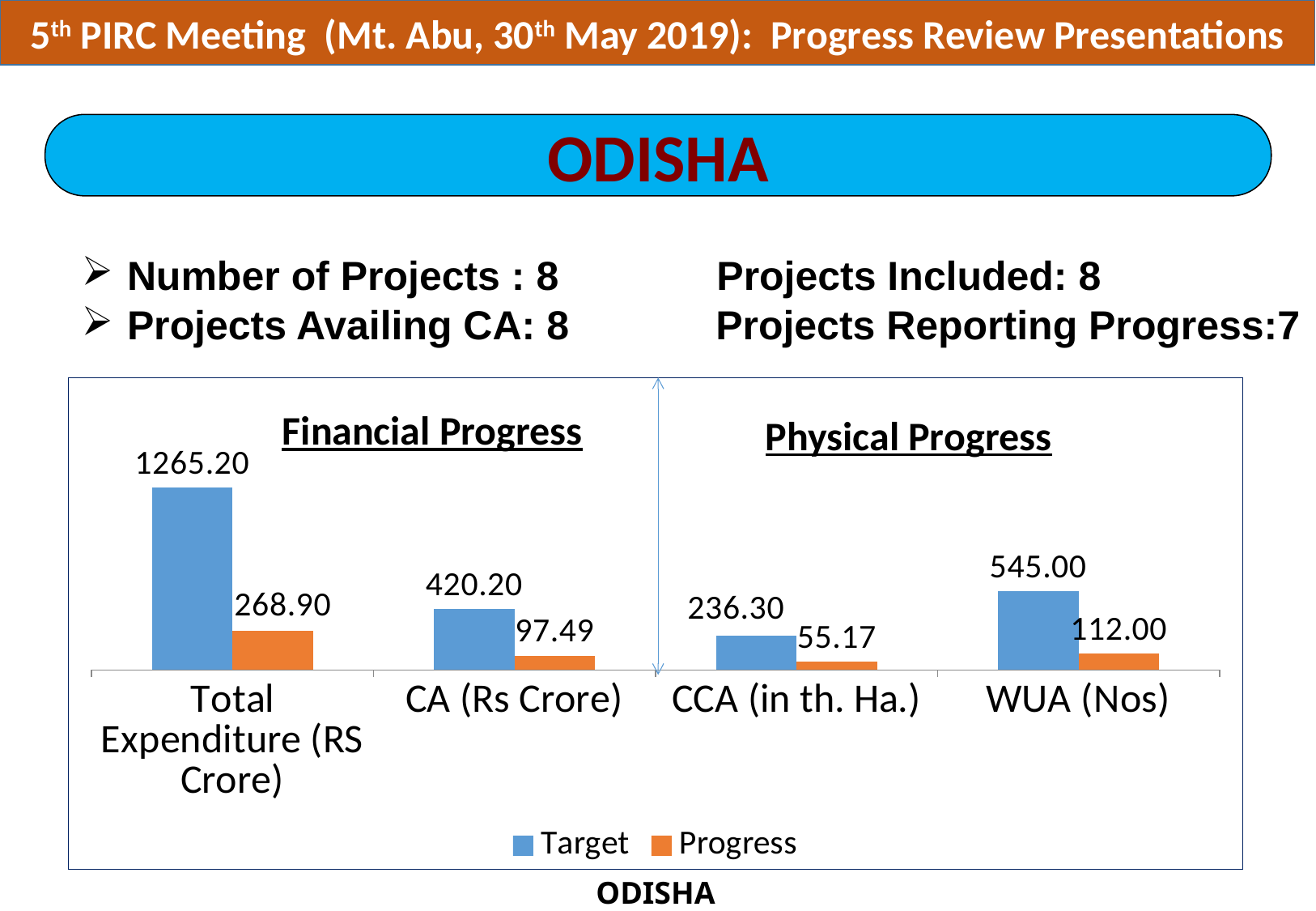
What is the Progress value for CA (Rs Crore)? 97.49 Which category has the lowest Progress value? CCA (in th. Ha.) Which is larger: the Progress value for Total Expenditure (RS Crore) or the Target value for CCA (in th. Ha.)? Progress value for Total Expenditure (RS Crore) What is the difference between the Target and Progress values for Total Expenditure (RS Crore)? 996.30 What is the difference between the Target and Progress values for WUA (Nos)? 433.00 Which category has the highest Target value? Total Expenditure (RS Crore) How many categories are shown on the x axis of the chart? 4 How many series does the chart legend list? 2 What is the Target value for WUA (Nos)? 545.00 What kind of chart is shown on the slide? Bar chart What is the Progress value for CCA (in th. Ha.)? 55.17 What is the Target value for Total Expenditure (RS Crore)? 1265.20